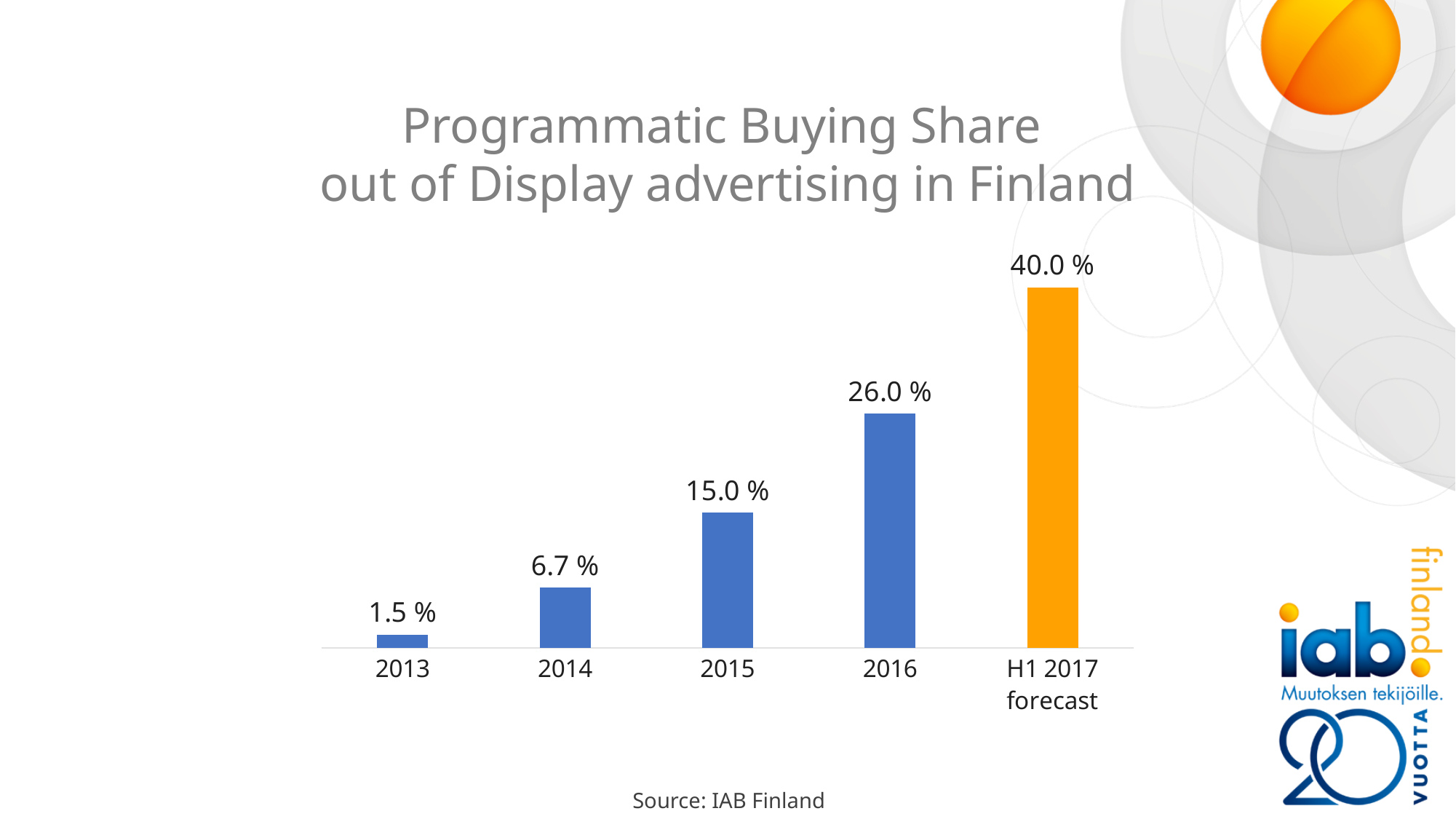
What is the difference between the 2016 share and the 2015 share? 11.0 % What is the programmatic buying share for 2013? 1.5 % What is the forecast programmatic buying share for H1 2017? 40.0 % Which is larger, the share for 2014 or the share for 2015? 2015 Which category has the highest programmatic buying share? H1 2017 forecast What is the difference between the H1 2017 forecast share and the 2016 share? 14.0 % What kind of chart is shown on the slide? Bar chart What is the programmatic buying share for 2015? 15.0 % How many categories are shown on the x axis? 5 Which bar is coloured orange instead of blue? H1 2017 forecast Do the values rise or fall from 2013 to H1 2017 forecast? Rise Which year has the lowest programmatic buying share? 2013